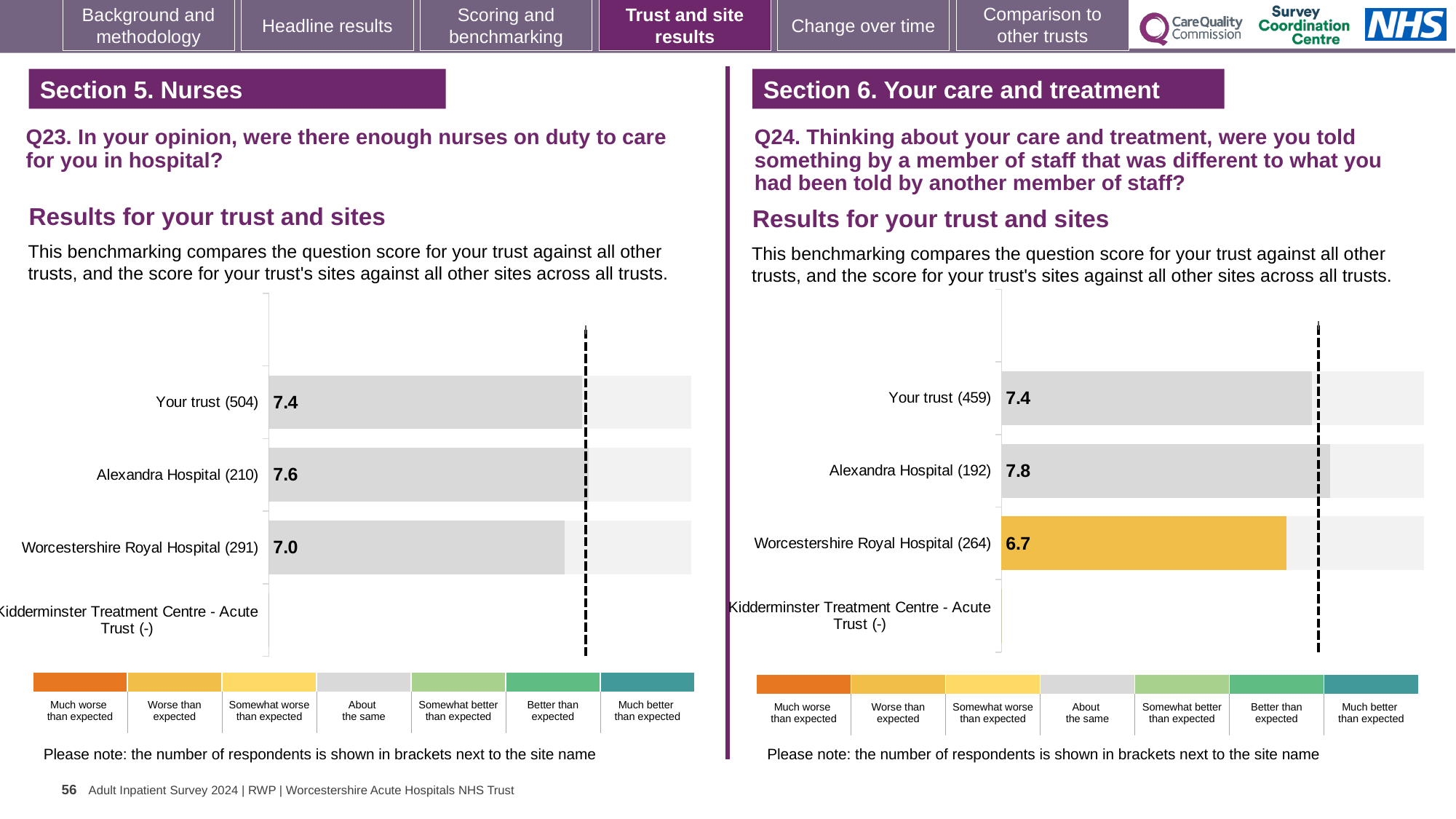
On the Q24 chart (right), which site or trust has the highest score? Alexandra Hospital On the Q23 chart (left), what is the score for Worcestershire Royal Hospital? 7.0 On the Q24 chart (right), what is the difference between the scores for Alexandra Hospital and Worcestershire Royal Hospital? 1.1 On the Q24 chart (right), how many respondents are shown in brackets for Alexandra Hospital? 192 On the Q23 chart (left), which site or trust has the lowest score? Worcestershire Royal Hospital How many categories are listed on the Q24 chart (right)? 4 On the Q23 chart (left), what is the difference between the scores for Alexandra Hospital and Your trust? 0.2 On the Q24 chart (right), what is the score for Worcestershire Royal Hospital? 6.7 On the Q23 chart (left), what is the score for Alexandra Hospital? 7.6 On the Q24 chart (right), what is the score for Your trust? 7.4 What type of chart is the Q23 chart (left)? Bar chart On the Q23 chart (left), which has the higher score, Your trust or Worcestershire Royal Hospital? Your trust